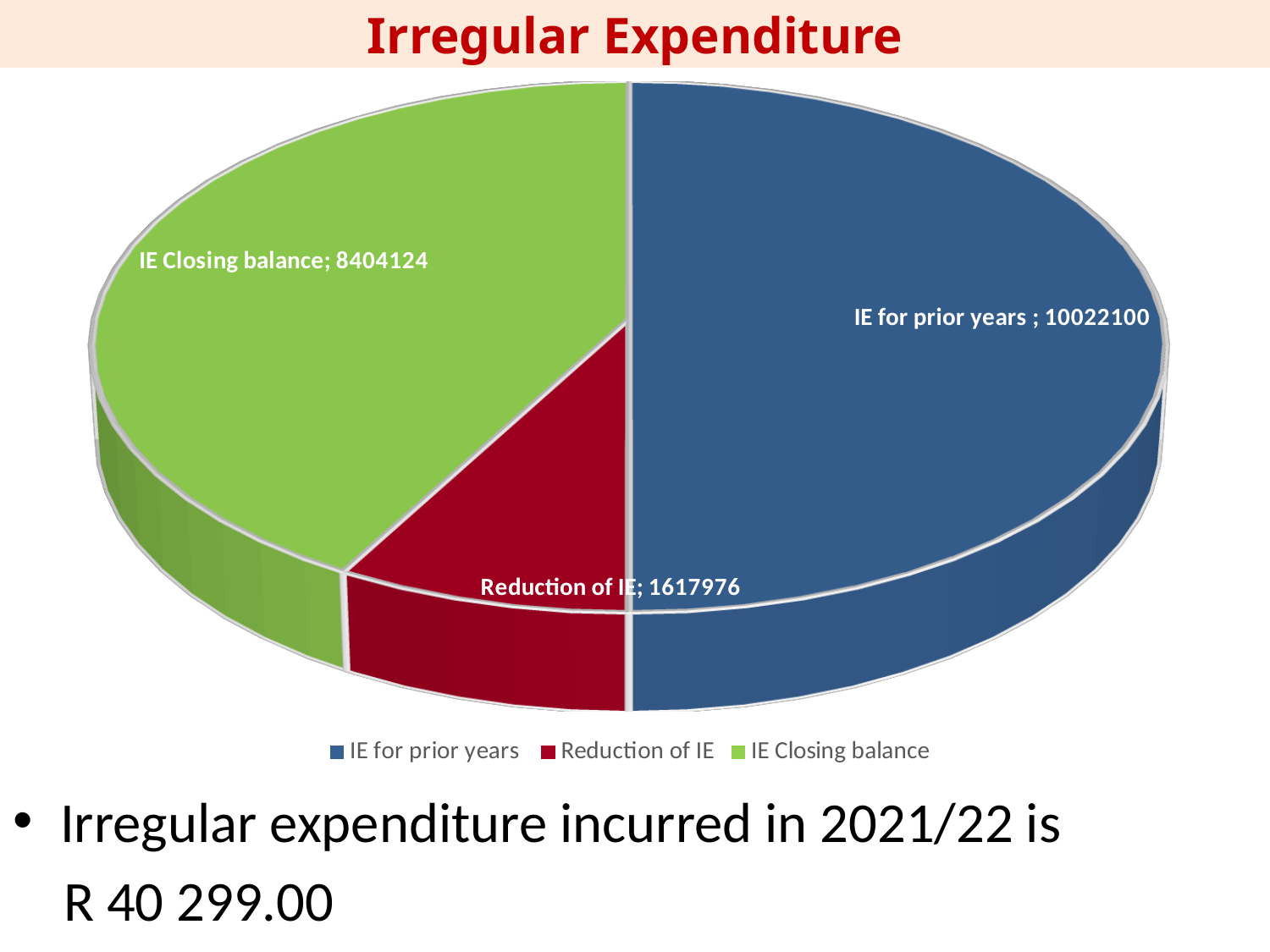
What is the value for Reduction of IE? 1617976 What is the title of the chart? Irregular Expenditure What share of the pie does IE for prior years represent? 50% Which is larger, IE Closing balance or Reduction of IE? IE Closing balance Which category has the largest slice of the pie? IE for prior years How many slices does the pie chart have? 3 What kind of chart is shown on the slide? Pie chart Which category has the smallest slice of the pie? Reduction of IE What is the value for IE Closing balance? 8404124 What is the difference between IE Closing balance and Reduction of IE? 6786148 What is the value for IE for prior years? 10022100 What is the difference between IE for prior years and IE Closing balance? 1617976